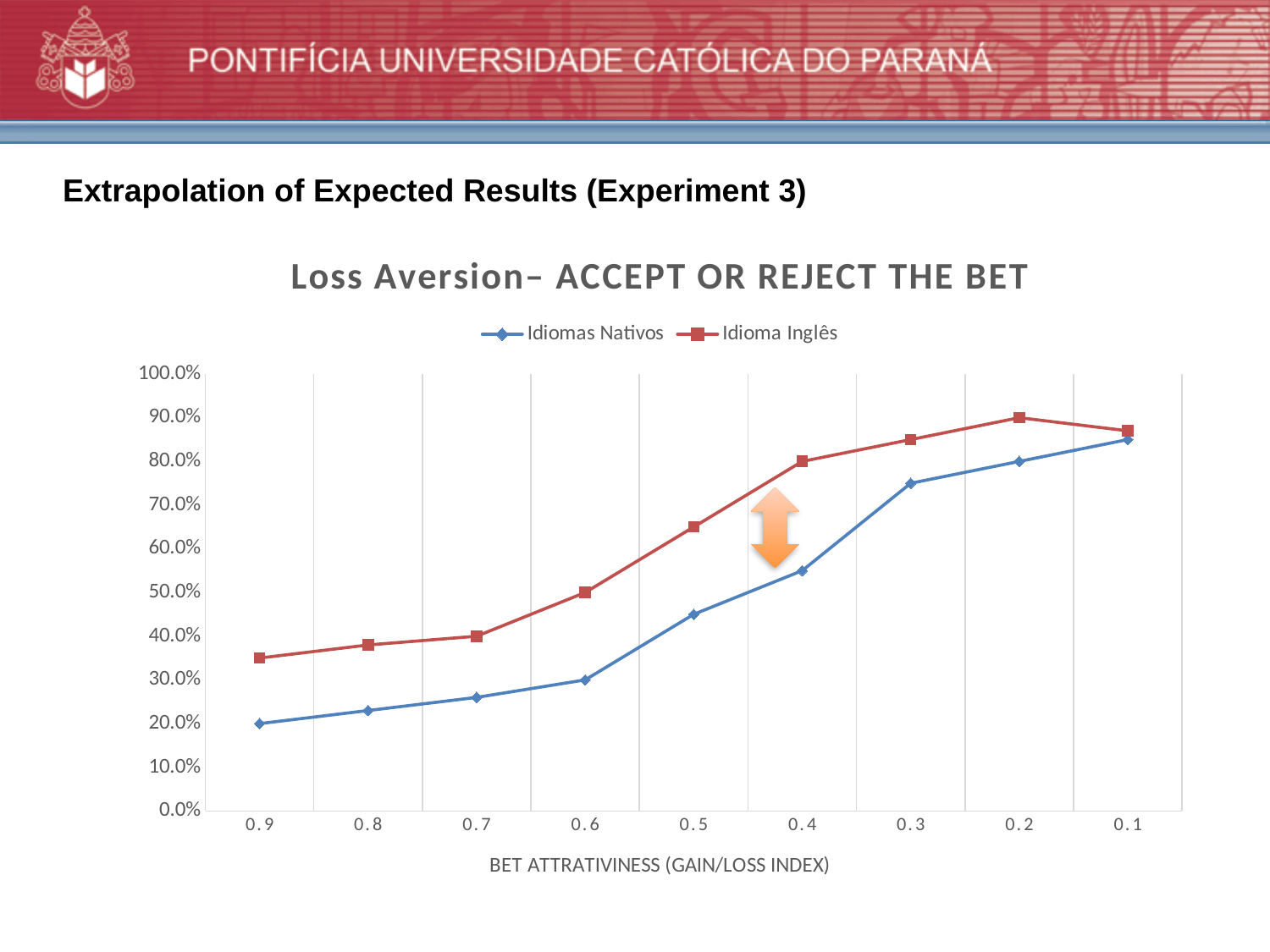
What is the label of the x axis? BET ATTRATIVINESS (GAIN/LOSS INDEX) At which x-axis value is the Idiomas Nativos series lowest? 0.9 What kind of chart is shown on the slide? line chart At x = 0.4, which series has the higher value, Idiomas Nativos or Idioma Inglês? Idioma Inglês Is the value for Idiomas Nativos at 0.6 greater or less than 40.0%? less At which x-axis value does the Idioma Inglês series reach its highest point? 0.2 How many points are plotted along the x axis for each series? 9 Does the Idiomas Nativos series rise or fall as the x axis goes from 0.9 to 0.1? rise Is the value for Idioma Inglês at 0.5 greater or less than 60.0%? greater How many series does the legend list? 2 Is the value for Idioma Inglês at 0.1 greater or less than 80.0%? greater